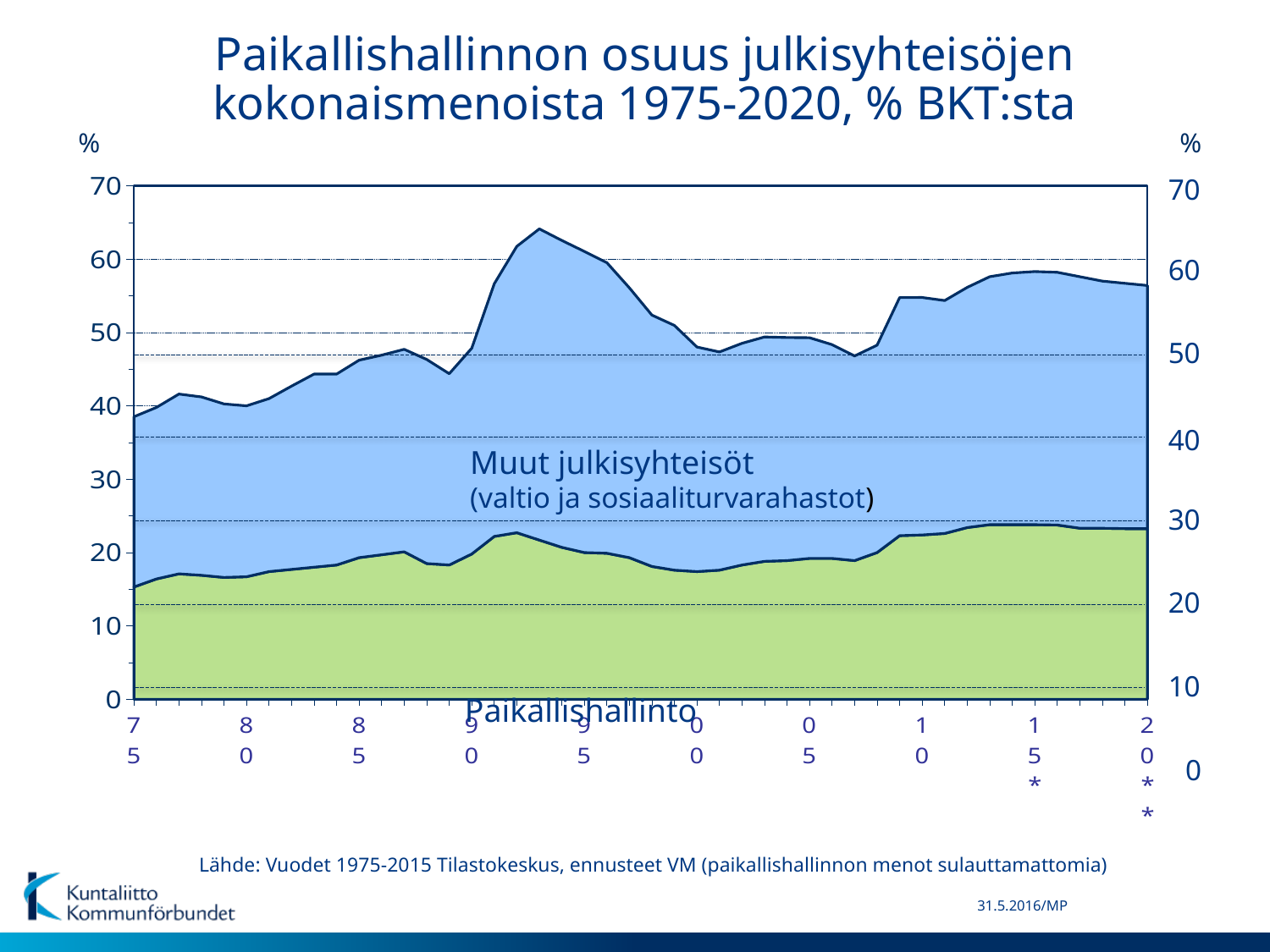
What kind of chart is shown on the slide? Stacked area chart Is the total value (top of the blue area) at its peak in the early 1990s greater or less than 60? greater How many series are plotted in the chart? 2 Does the total value (top of the blue area) rise or fall from 1975 to the early 1990s? rise Is the value for Paikallishallinto in 2015 greater or less than 20? greater What is the title of the chart? Paikallishallinnon osuus julkisyhteisöjen kokonaismenoista 1975-2020, % BKT:sta Which series has the larger share throughout the period, Paikallishallinto or Muut julkisyhteisöt? Muut julkisyhteisöt Is the value for Paikallishallinto in 1975 greater or less than 20? less How many year labels are shown on the x axis? 10 Which series is shown in green at the bottom of the chart? Paikallishallinto